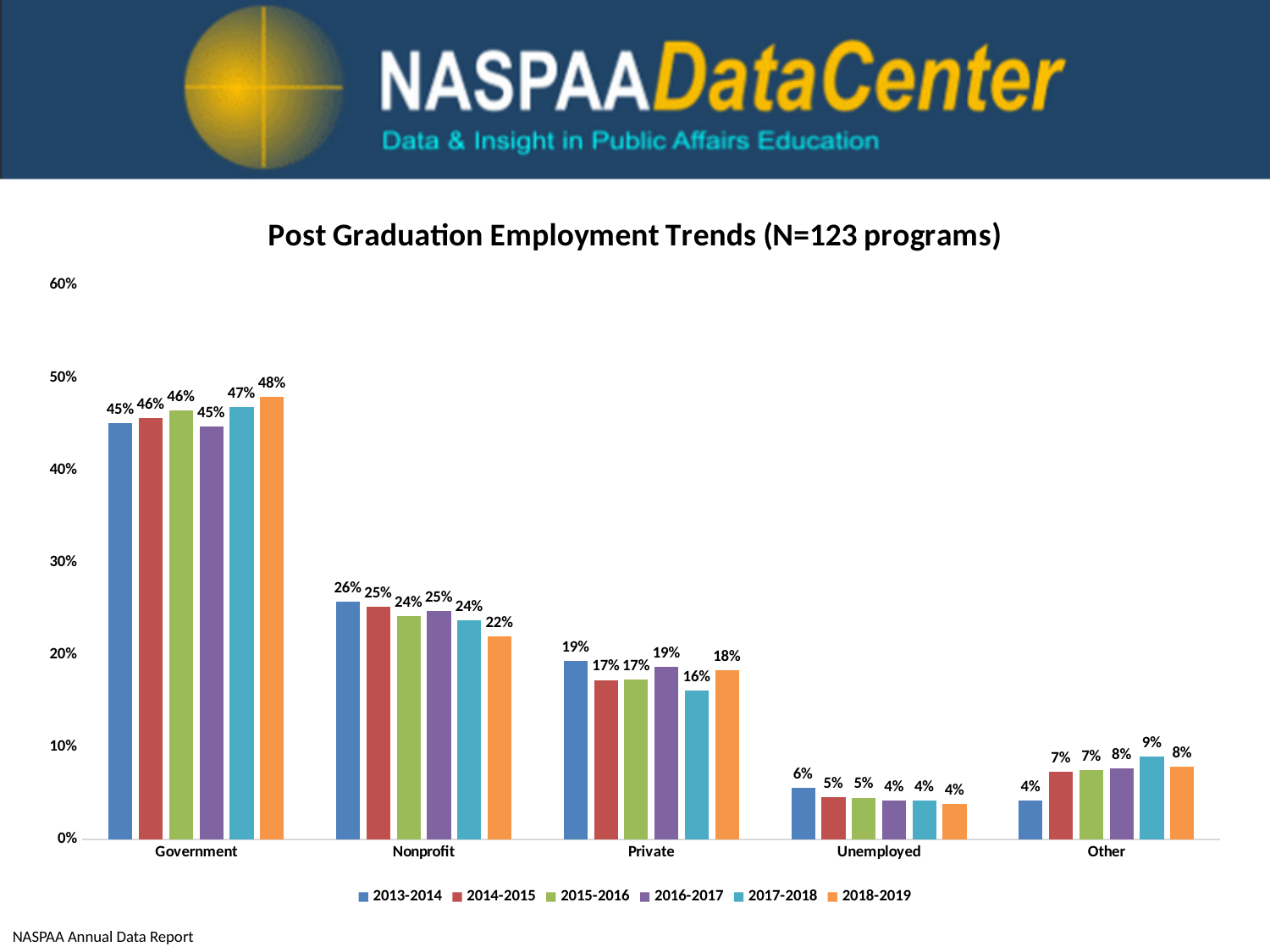
What is the difference between the Government value in 2018-2019 and the Government value in 2013-2014? 3% What is the value for Private in 2017-2018? 16% What is the title of the chart? Post Graduation Employment Trends (N=123 programs) How many series does the legend list? 6 What is the value for Nonprofit in 2013-2014? 26% What kind of chart is shown on the slide? Bar chart What is the value for Government in 2018-2019? 48% What is the value for Other in 2013-2014? 4% Which category has the highest value in 2018-2019? Government Which year has the lowest value for Nonprofit? 2018-2019 Which is larger: the Unemployed value in 2013-2014 or the Other value in 2013-2014? Unemployed value in 2013-2014 How many categories are shown on the x axis? 5